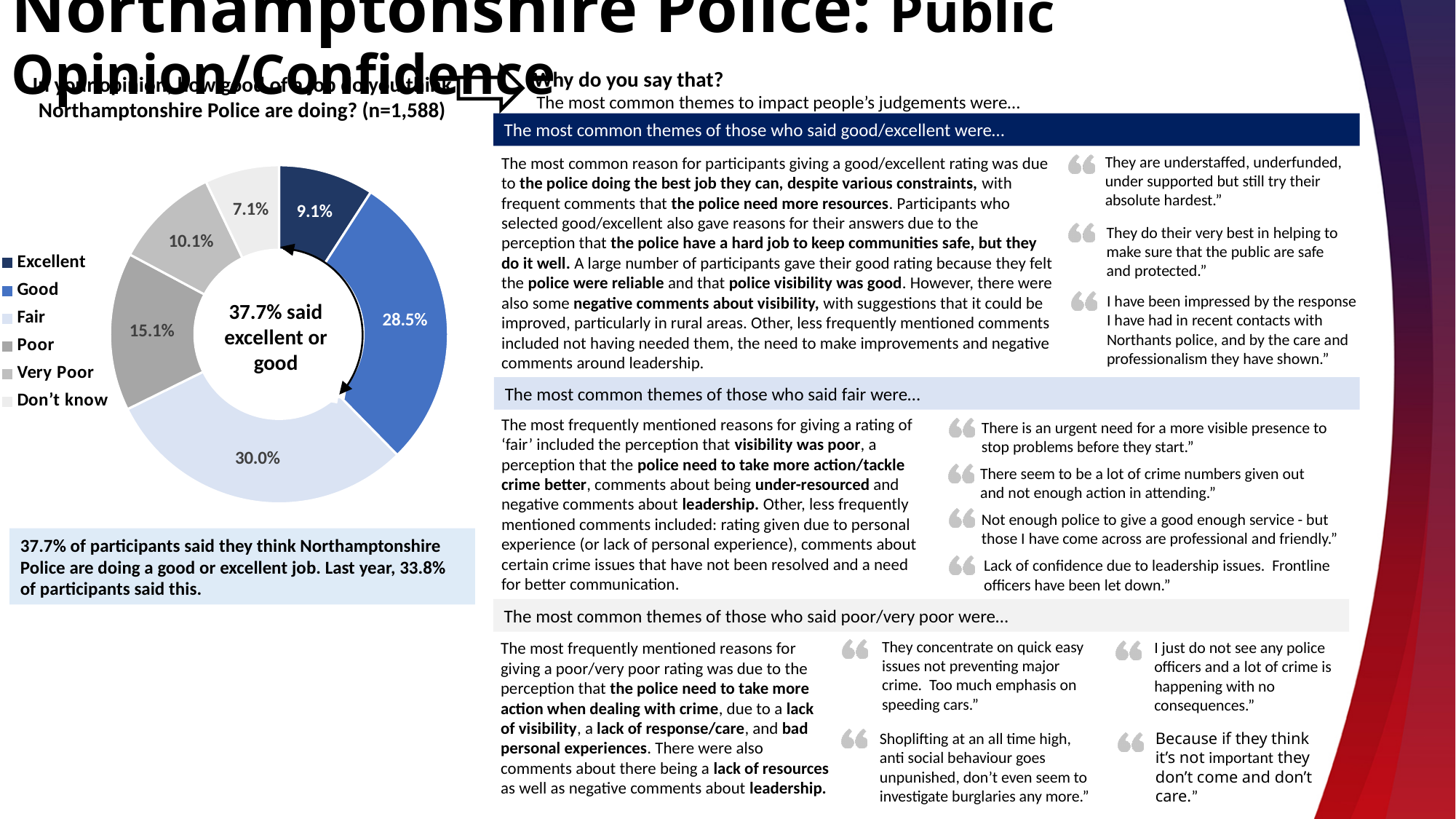
Which rating category has the smallest share of the donut chart? Don't know What percentage of participants said good or excellent last year, according to the note below the chart? 33.8% How many rating categories are shown in the donut chart? 6 What percentage of respondents rated Northamptonshire Police as Good? 28.5% Which is larger, the share for Poor or the share for Very Poor? Poor What combined percentage of respondents said excellent or good, according to the text in the centre of the chart? 37.7% What is the sample size (n) stated in the chart's question title? 1,588 Which rating category has the largest share of the donut chart? Fair What percentage of respondents answered Don't know? 7.1% What is the difference in percentage points between the Fair and Poor shares? 14.9 What type of chart is used to show the ratings of Northamptonshire Police? Donut (pie) chart What percentage of respondents rated Northamptonshire Police as Excellent? 9.1%